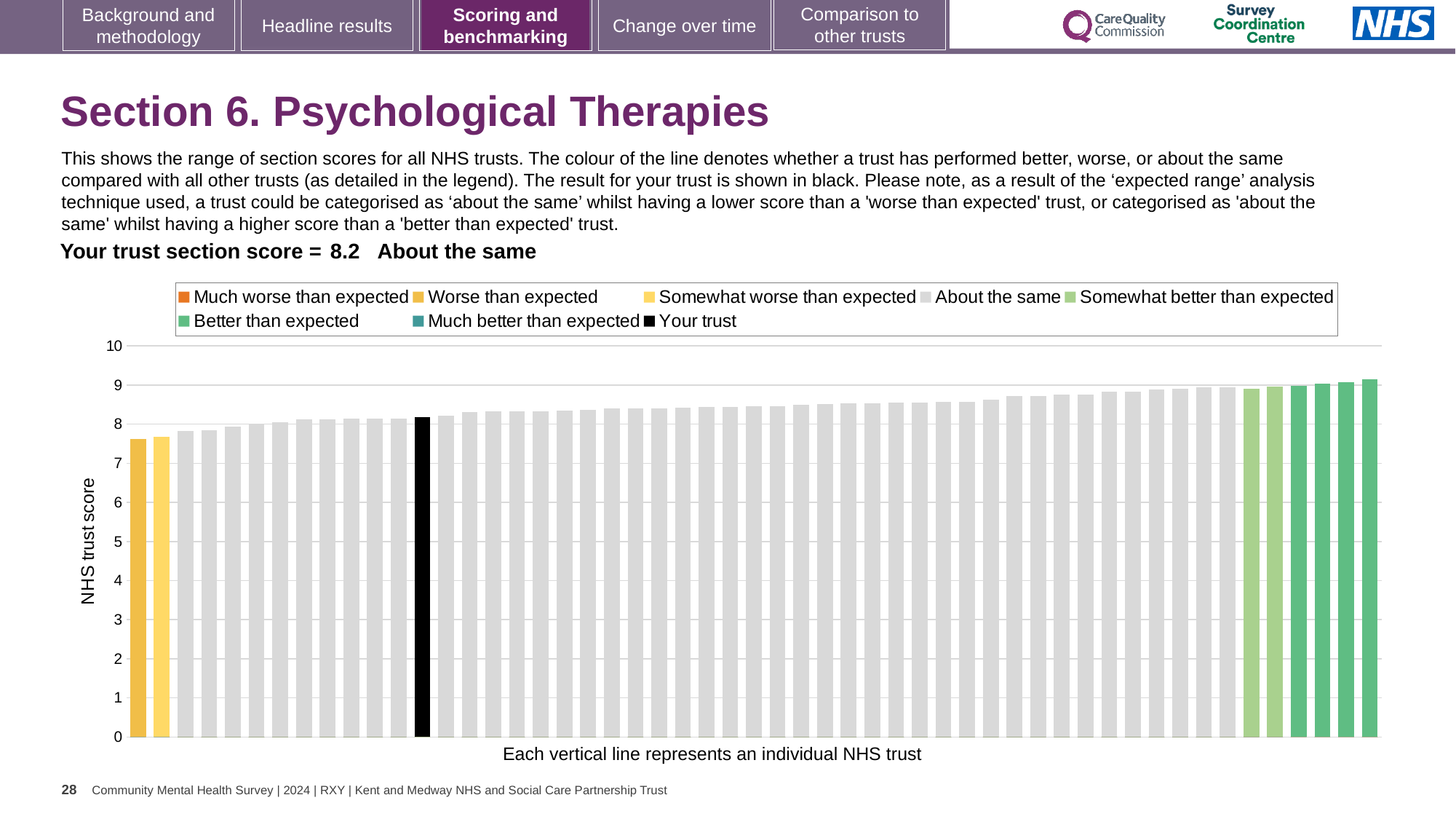
Is the value of the leftmost (lowest) bar greater or less than 8? less Is the value of the leftmost (lowest) bar greater or less than 7? greater How many entries does the chart legend list? 8 Is the value of the black 'Your trust' bar greater or less than 8? greater Do the bar values rise or fall from left to right along the x axis? rise What is the label on the vertical axis of the chart? NHS trust score What category does your trust fall into according to the text above the chart? About the same What is your trust's section score shown on the slide? 8.2 Which is larger, the value of the black 'Your trust' bar or the value of the rightmost bar? the rightmost bar What kind of chart is shown on the slide? bar chart What colour is the bar representing your trust? black